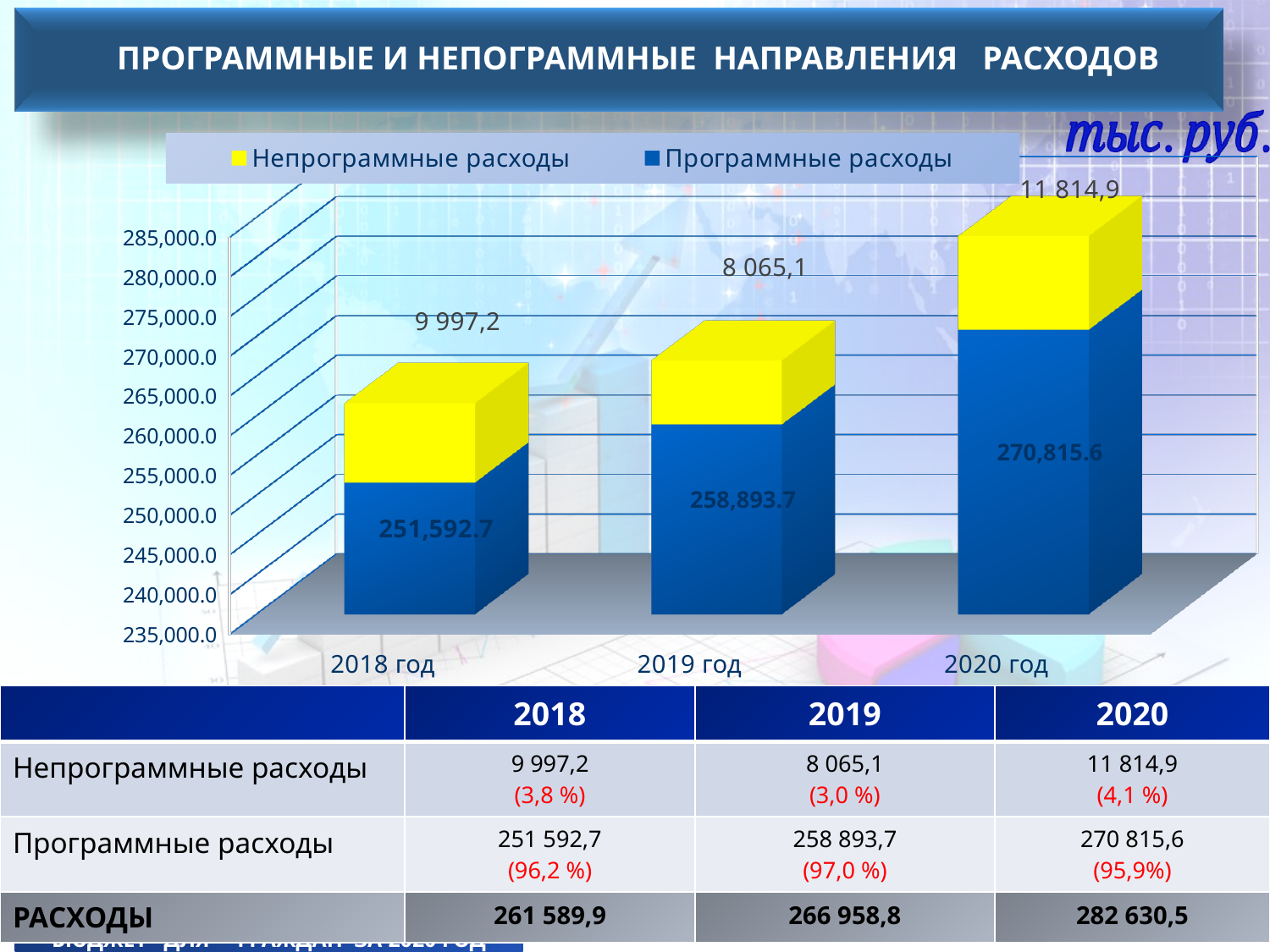
Do the values of Программные расходы rise or fall from 2018 год to 2020 год? rise What is the difference between Программные расходы in 2020 год and 2018 год? 19,222.9 What is the value of Непрограммные расходы for 2019 год in the chart? 8 065,1 Which colour represents Непрограммные расходы in the chart? yellow Which is larger: Непрограммные расходы in 2018 год or in 2019 год? 2018 год How many years (categories) are shown on the x axis of the chart? 3 How many series does the chart legend list? 2 What is the value of Программные расходы for 2018 год in the chart? 251,592.7 What is the value of Непрограммные расходы for 2020 год in the chart? 11 814,9 What type of chart is shown on the slide? stacked bar chart In which year is the value of Непрограммные расходы the lowest? 2019 год In which year is the value of Программные расходы the highest? 2020 год